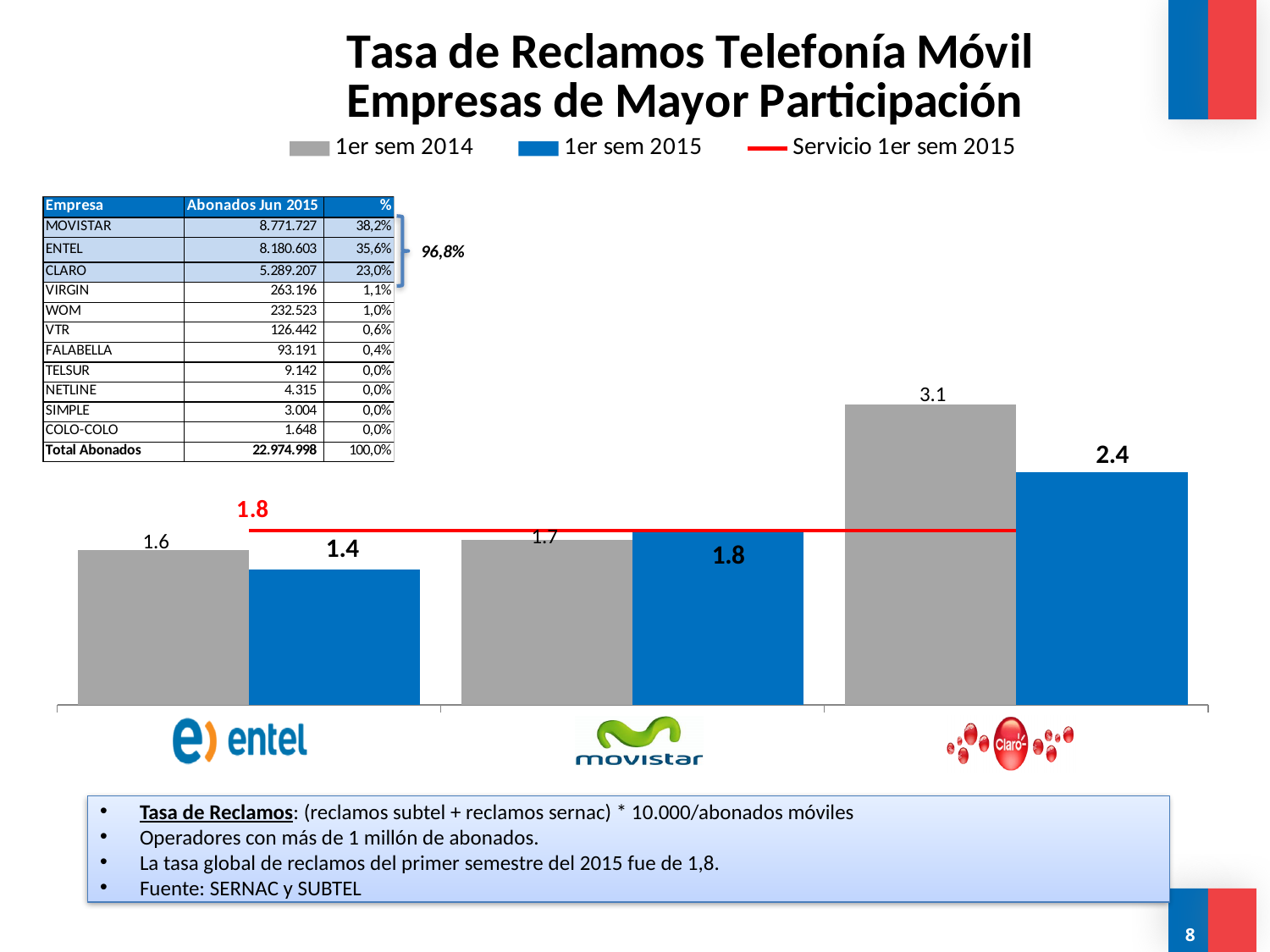
Which company has the highest 1er sem 2015 value? Claro Which company has the lowest 1er sem 2015 value? Entel What is the 1er sem 2015 value for Movistar? 1.8 What kind of chart is shown? Combination bar and line chart How many companies are shown on the chart? 3 What is the 1er sem 2014 value for Claro? 3.1 How many series does the legend list? 3 Which is larger for Movistar: the 1er sem 2014 value or the 1er sem 2015 value? 1er sem 2015 What is the 1er sem 2014 value for Entel? 1.6 What is the 1er sem 2015 value for Claro? 2.4 What is the difference between Claro's 1er sem 2014 and 1er sem 2015 values? 0.7 What value does the red 'Servicio 1er sem 2015' line mark? 1.8